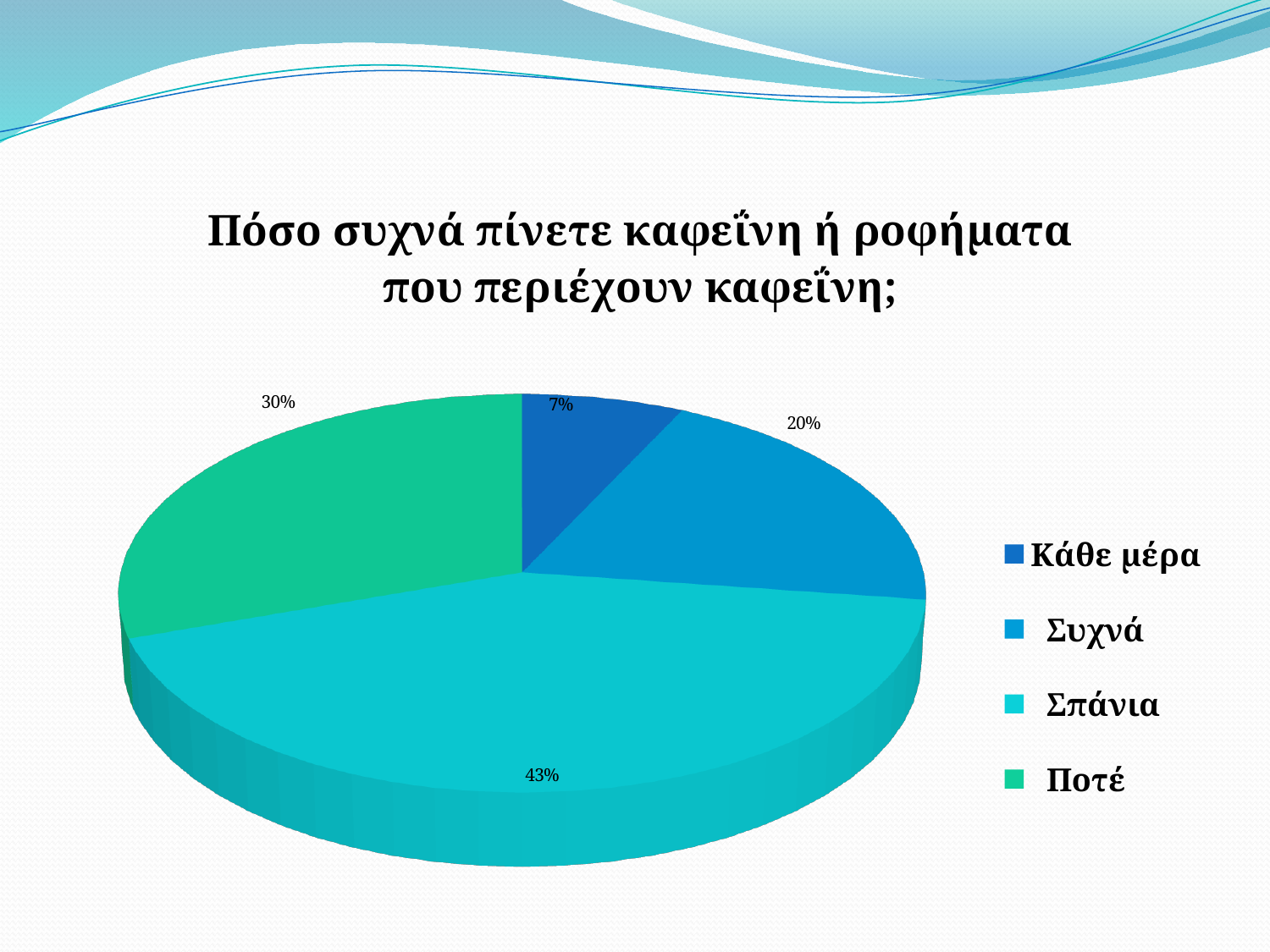
What share of the pie does Κάθε μέρα represent? 7% What kind of chart is shown on the slide? Pie chart What is the difference in percentage points between Σπάνια and Ποτέ? 13 What is the difference in percentage points between Συχνά and Κάθε μέρα? 13 Which category has the smallest slice of the pie? Κάθε μέρα How many categories does the pie chart show? 4 Which is larger, the share for Ποτέ or the share for Συχνά? Ποτέ What share of the pie does Ποτέ represent? 30% Which category has the largest slice of the pie? Σπάνια What share of the pie does Σπάνια represent? 43% What is the title of the chart? Πόσο συχνά πίνετε καφεΐνη ή ροφήματα που περιέχουν καφεΐνη;